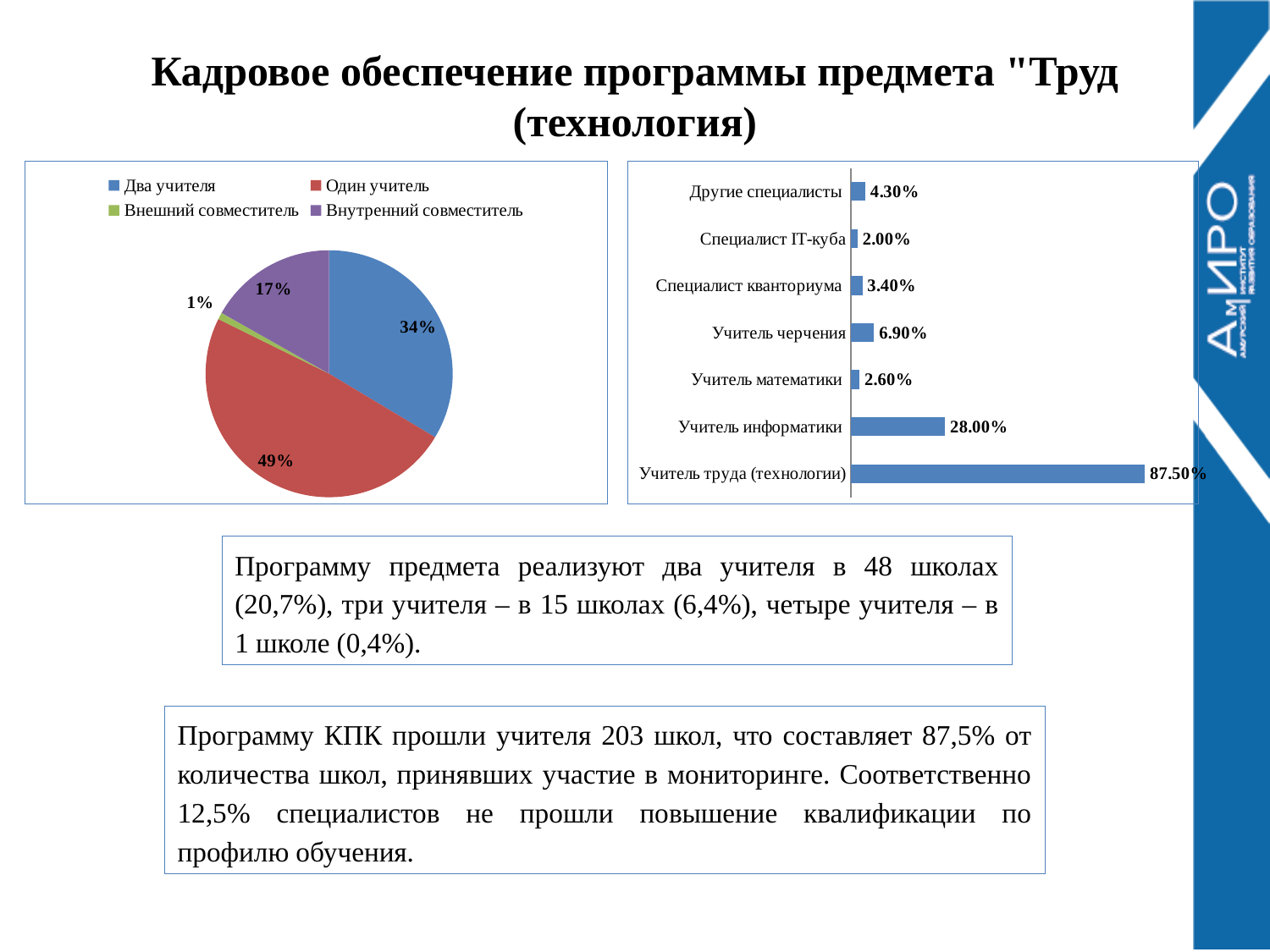
In the pie chart on the left, what share does "Внутренний совместитель" have? 17% In the pie chart on the left, which category has the largest slice? Один учитель In the pie chart on the left, which category has the smallest slice? Внешний совместитель In the bar chart on the right, what is the value for "Специалист кванториума"? 3.40% In the pie chart on the left, how many categories does the legend list? 4 In the pie chart on the left, what share does "Один учитель" have? 49% In the bar chart on the right, what is the value for "Учитель информатики"? 28.00% What type of chart is shown on the right side of the slide? Bar chart In the bar chart on the right, how many categories are shown? 7 In the bar chart on the right, which category has the highest value? Учитель труда (технологии) In the pie chart on the left, what is the difference between the shares of "Один учитель" and "Два учителя"? 15% In the bar chart on the right, which category has the lowest value? Специалист IT-куба